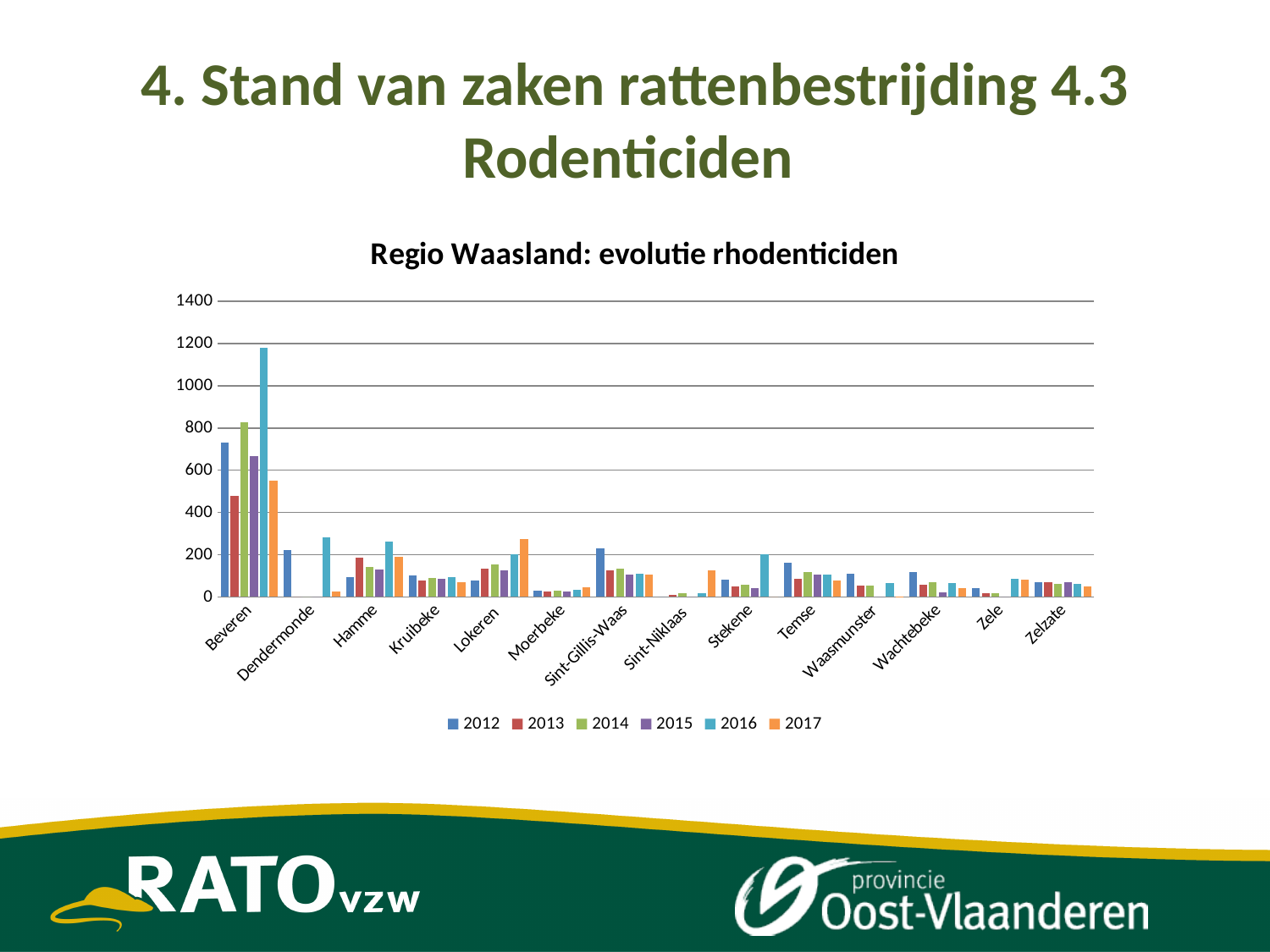
What kind of chart is shown on the slide? bar chart For Beveren, which is larger: the 2013 value or the 2014 value? 2014 Which legend entry is shown in orange? 2017 How many municipalities (categories) are shown on the x axis? 14 What is the title of the chart? Regio Waasland: evolutie rhodenticiden Which year has the highest value for Beveren? 2016 Which municipality has the tallest bar in the chart? Beveren Is the 2016 value for Dendermonde greater or less than 200? greater Is the 2012 value for Beveren greater or less than 600? greater Is the 2016 value for Beveren greater or less than 1000? greater How many series does the legend list? 6